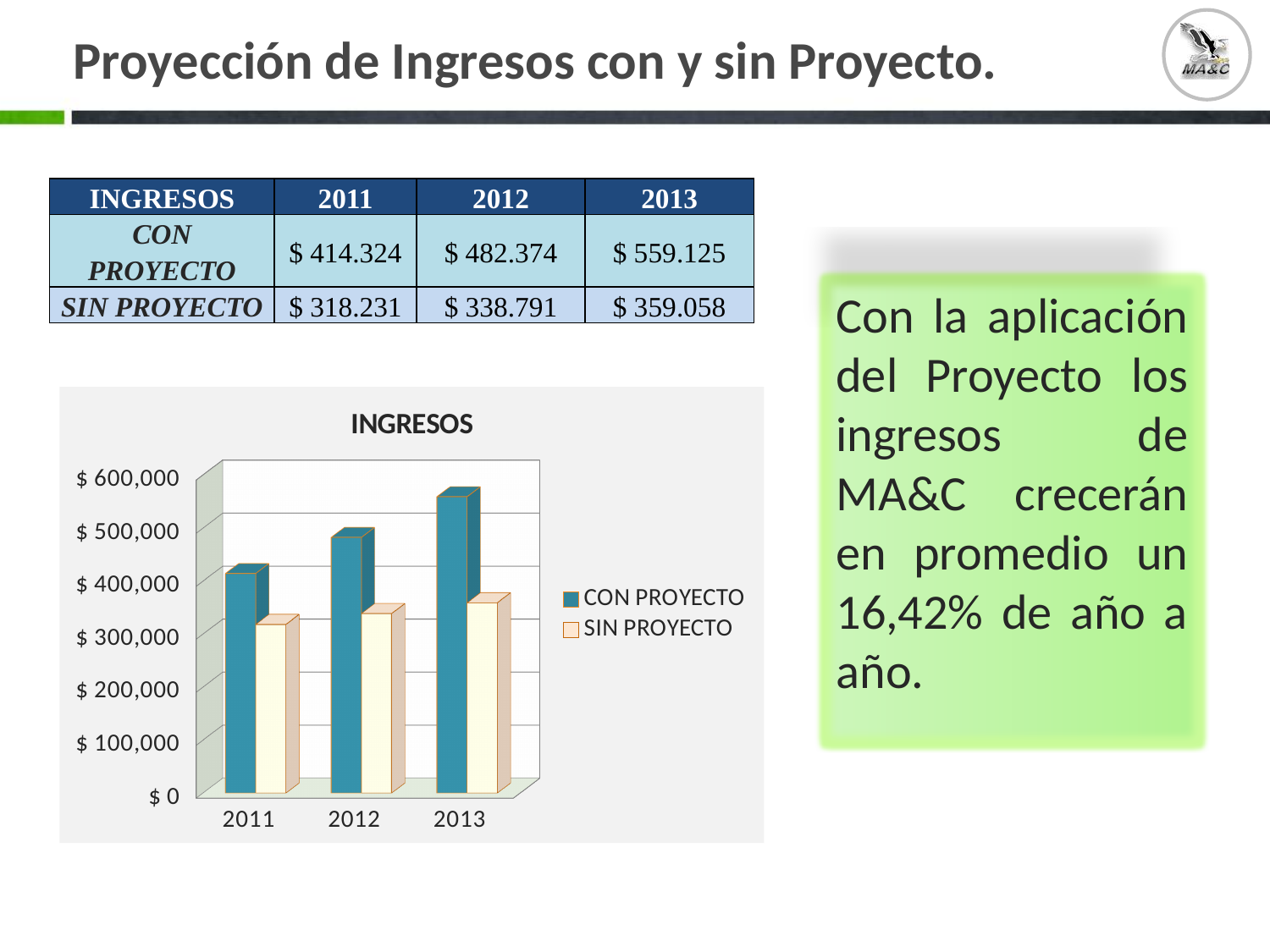
Do the CON PROYECTO values rise or fall from 2011 to 2013? rise What type of chart is shown on the slide? bar chart In which year is the SIN PROYECTO value lowest? 2011 What is the title of the chart? INGRESOS What is the value for SIN PROYECTO in 2011? $ 318.231 What is the value for CON PROYECTO in 2013? $ 559.125 How many series does the chart legend list? 2 What is the difference between CON PROYECTO and SIN PROYECTO in 2013? $ 200.067 How many years are shown on the x axis of the chart? 3 Which is larger in 2012, CON PROYECTO or SIN PROYECTO? CON PROYECTO In which year is the CON PROYECTO value highest? 2013 Is the CON PROYECTO value for 2013 greater or less than $ 500,000? greater